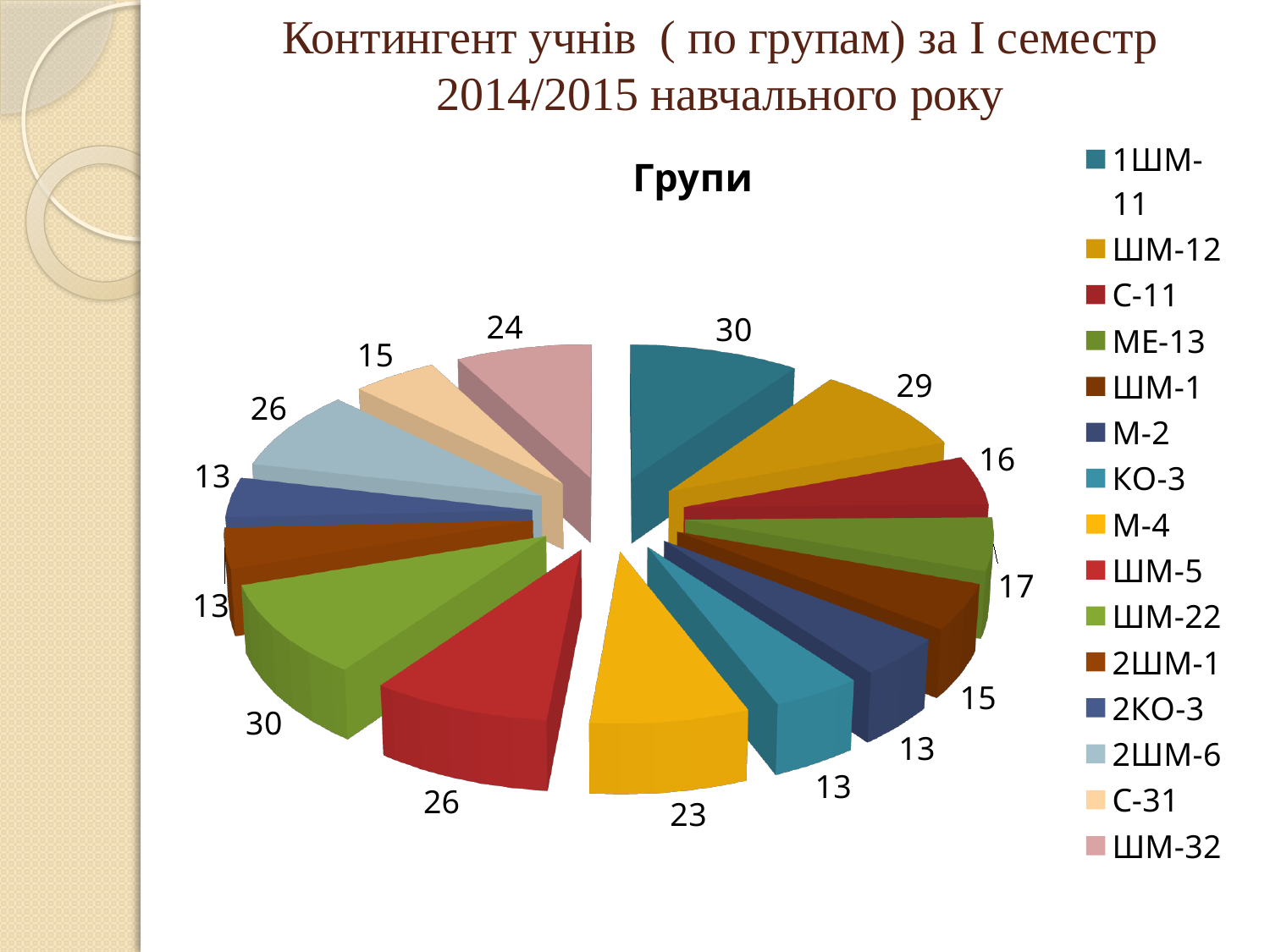
Which group has the larger value, М-4 or МЕ-13? М-4 What type of chart is shown on the slide? pie chart What is the value for the 1ШМ-11 group? 30 What is the largest value shown on the pie chart? 30 What is the value for the М-4 group? 23 What is the value for the ШМ-32 group? 24 What is the value for the С-11 group? 16 What is the value for the 2ШМ-6 group? 26 What is the title of the chart? Групи How many groups are listed in the legend? 15 What is the value for the ШМ-12 group? 29 What is the difference between the values for ШМ-12 and С-11? 13